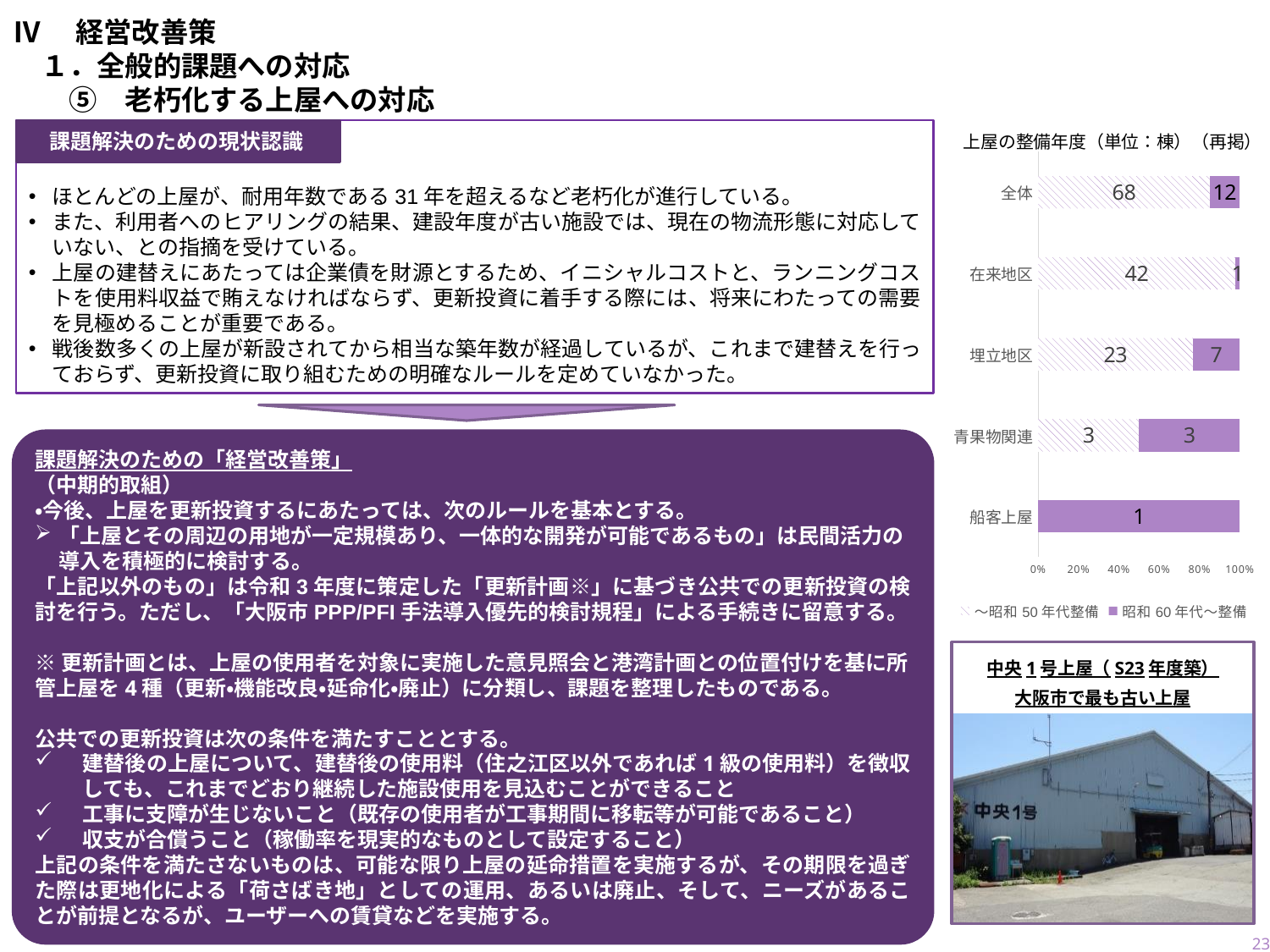
In the 「上屋の整備年度」 chart, what is the difference between the 「～昭和50年代整備」 value and the 「昭和60年代～整備」 value for 全体? 56 In the 「上屋の整備年度」 chart, which series is shown with a solid purple fill? 昭和60年代～整備 How many categories are plotted in the 「上屋の整備年度」 chart? 5 How many series does the legend of the 「上屋の整備年度」 chart list? 2 In the 「上屋の整備年度」 chart, what is the value of 「～昭和50年代整備」 for 全体? 68 In the 「上屋の整備年度」 chart, what is the value of 「昭和60年代～整備」 for 埋立地区? 7 In the 「上屋の整備年度」 chart, what is the value of 「～昭和50年代整備」 for 在来地区? 42 What kind of chart is shown under the title 「上屋の整備年度（単位：棟）（再掲）」? bar chart In the 「上屋の整備年度」 chart, what is the total number of 棟 for 埋立地区 (both series combined)? 30 In the 「上屋の整備年度」 chart, which is larger for 青果物関連: the 「～昭和50年代整備」 value or the 「昭和60年代～整備」 value? They are equal (3 each) In the 「上屋の整備年度」 chart, what is the value of 「昭和60年代～整備」 for 全体? 12 In the 「上屋の整備年度」 chart, which category has the highest 「～昭和50年代整備」 value? 全体